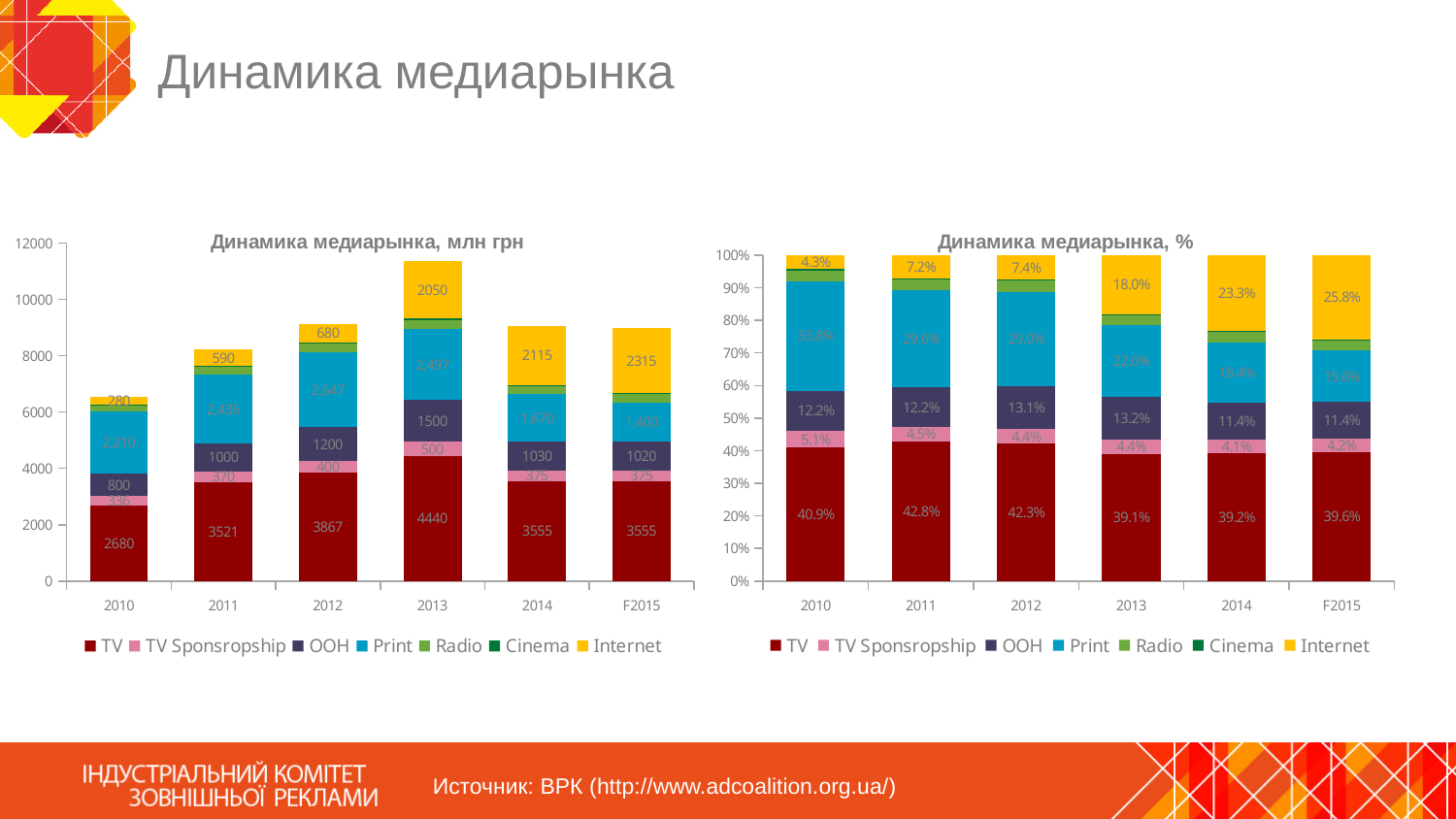
In the chart titled "Динамика медиарынка, млн грн", in which year is the TV value lowest? 2010 In the chart titled "Динамика медиарынка, млн грн", what is the value for TV in 2013? 4440 What kind of chart is the chart titled "Динамика медиарынка, %"? Stacked bar chart In the chart titled "Динамика медиарынка, млн грн", what is the value for Internet in F2015? 2315 How many years are shown on the x axis of the chart titled "Динамика медиарынка, %"? 6 In the chart titled "Динамика медиарынка, млн грн", in which year is the TV value highest? 2013 In the chart titled "Динамика медиарынка, %", which is larger in 2010: the share of Print or the share of OOH? Print In the chart titled "Динамика медиарынка, %", does the share of Internet rise or fall from 2010 to F2015? Rise How many series does the legend of the chart titled "Динамика медиарынка, млн грн" list? 7 In the chart titled "Динамика медиарынка, млн грн", what is the difference between the Internet values for 2013 and 2012? 1370 In the chart titled "Динамика медиарынка, %", what is the share of Print in 2010? 33.8% In the chart titled "Динамика медиарынка, млн грн", is the total height of the 2013 stacked bar greater or less than 10000? greater